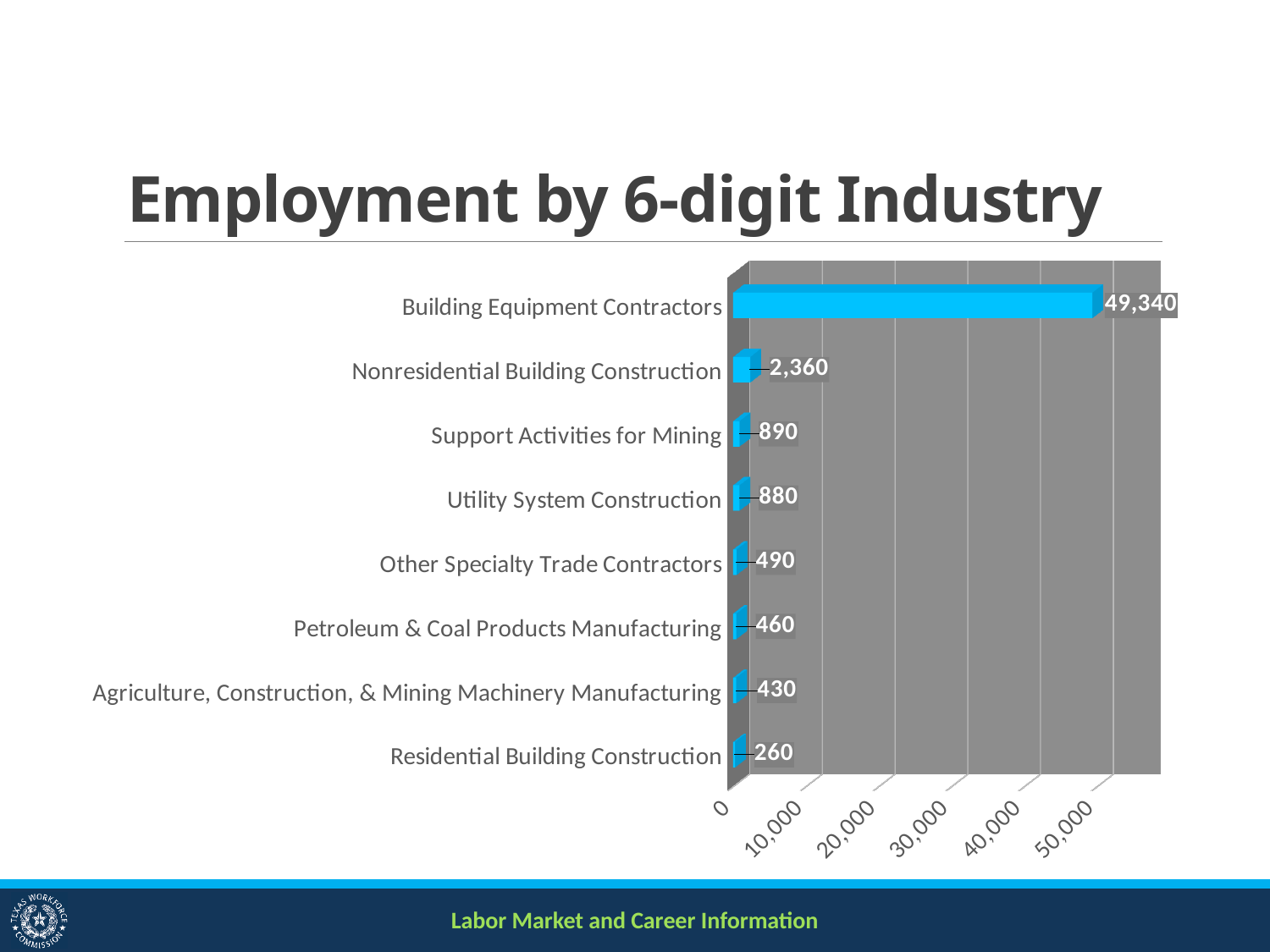
Which has higher employment, Other Specialty Trade Contractors or Petroleum & Coal Products Manufacturing? Other Specialty Trade Contractors Which industry has the highest employment? Building Equipment Contractors What kind of chart is shown on the slide? Bar chart What is the difference in employment between Building Equipment Contractors and Nonresidential Building Construction? 46,980 What is the employment value for Residential Building Construction? 260 What is the employment value for Building Equipment Contractors? 49,340 How many industries are shown in the chart? 8 Which industry has the lowest employment? Residential Building Construction What is the employment value for Nonresidential Building Construction? 2,360 What is the difference in employment between Support Activities for Mining and Utility System Construction? 10 Is the value for Building Equipment Contractors greater or less than 40,000? greater What is the employment value for Utility System Construction? 880